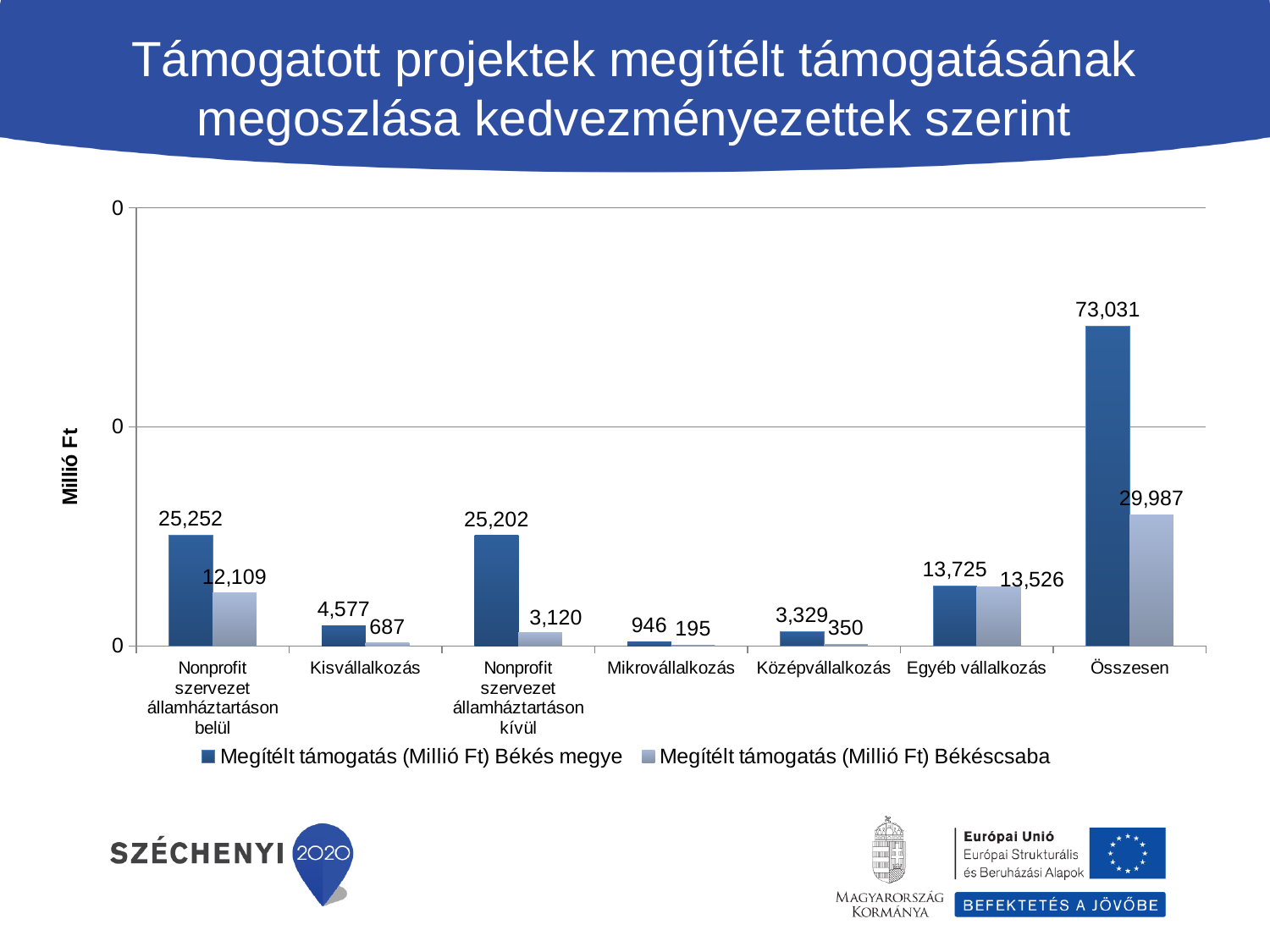
What is the value for Kisvállalkozás in the Megítélt támogatás (Millió Ft) Békéscsaba series? 687 What is the value for Egyéb vállalkozás in the Békés megye series? 13,725 How many series does the legend list? 2 Excluding Összesen, which category has the highest value in the Békés megye series? Nonprofit szervezet államháztartáson belül What kind of chart is shown on the slide? Bar chart How many categories are shown on the x axis? 7 Which category has the lowest value in the Békéscsaba series? Mikrovállalkozás What is the value for Mikrovállalkozás in the Békéscsaba series? 195 What is the difference between the Békés megye and Békéscsaba values for Nonprofit szervezet államháztartáson kívül? 22,082 What is the label of the vertical axis? Millió Ft What is the value for Összesen in the Megítélt támogatás (Millió Ft) Békés megye series? 73,031 Which is larger for Középvállalkozás: the Békés megye value or the Békéscsaba value? Békés megye